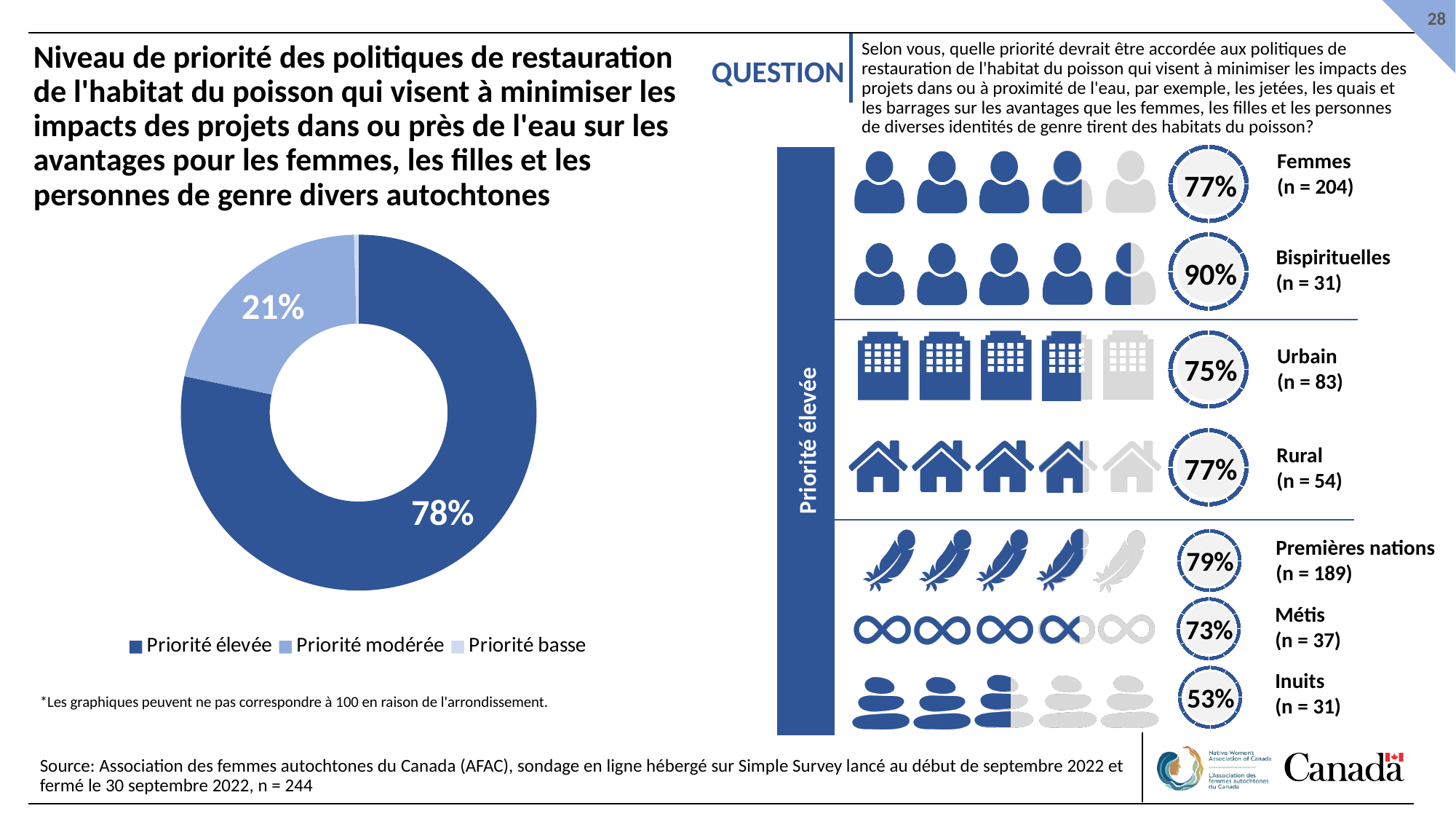
In the 'Priorité élevée' infographic on the right, what percentage is shown for Inuits? 53% In the donut chart, what is the difference in percentage points between 'Priorité élevée' and 'Priorité modérée'? 57 percentage points In the 'Priorité élevée' infographic on the right, which group has the lowest percentage? Inuits What kind of chart is shown on the left of the slide? Donut (pie) chart In the donut chart, which priority level has the largest share? Priorité élevée In the donut chart, what share of respondents chose 'Priorité modérée'? 21% How many categories does the legend of the donut chart list? 3 In the 'Priorité élevée' infographic on the right, which group has the highest percentage? Bispirituelles In the donut chart, what share of respondents chose 'Priorité élevée'? 78% In the 'Priorité élevée' infographic on the right, what percentage is shown for Bispirituelles? 90% In the 'Priorité élevée' infographic on the right, what is the difference in percentage points between Bispirituelles and Inuits? 37 percentage points In the 'Priorité élevée' infographic on the right, which is larger: the percentage for Urbain or for Premières nations? Premières nations